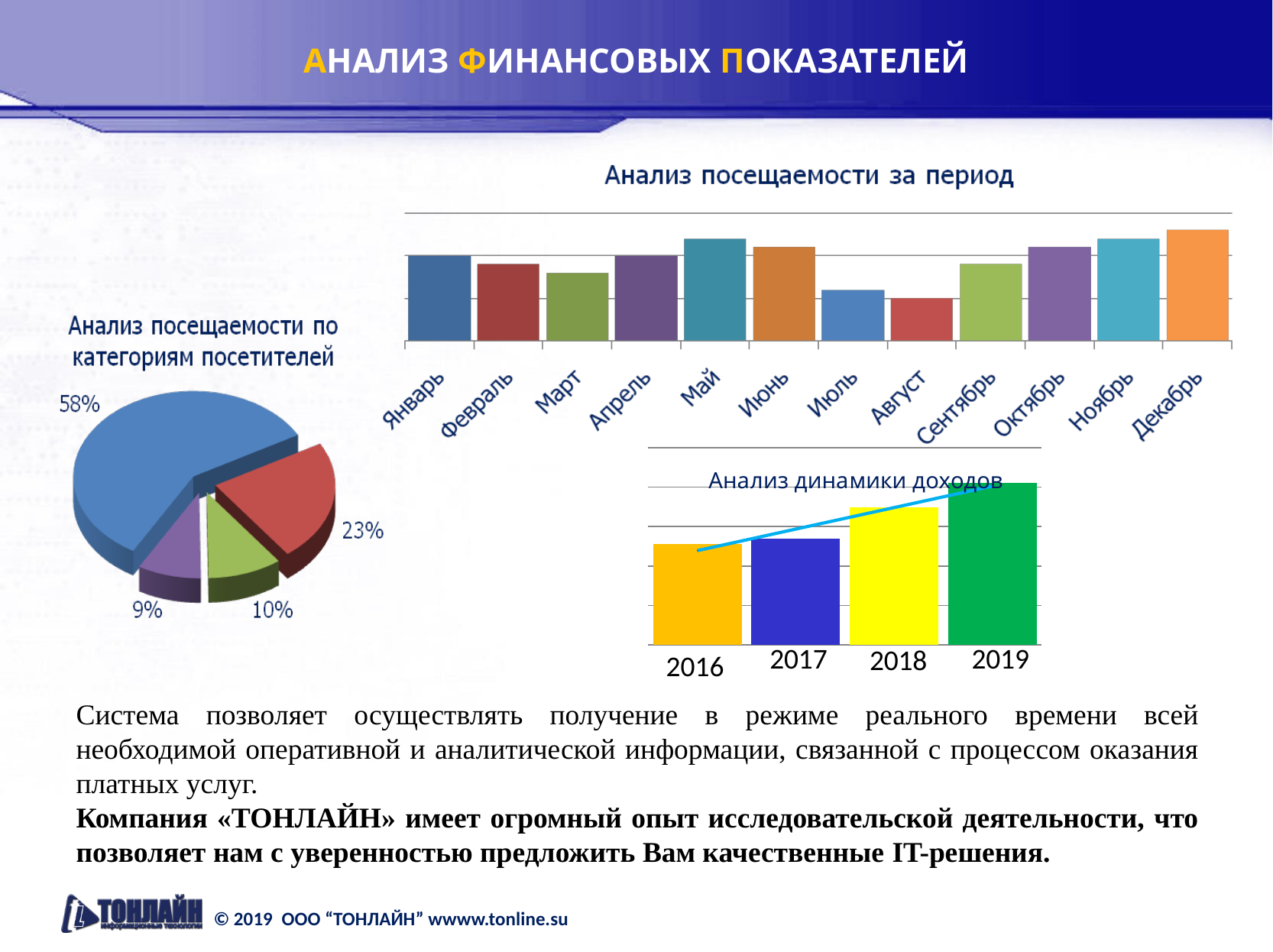
In the chart 'Анализ динамики доходов', do the values rise or fall from 2016 to 2019? Rise In the chart 'Анализ посещаемости за период', which month has the highest bar? Декабрь In the chart 'Анализ динамики доходов', which year has the lowest bar? 2016 What kind of chart is 'Анализ динамики доходов'? Bar chart How many slices does the pie chart 'Анализ посещаемости по категориям посетителей' have? 4 How many months are shown in the chart 'Анализ посещаемости за период'? 12 In the chart 'Анализ посещаемости за период', which month has the lowest bar? Август In the pie chart 'Анализ посещаемости по категориям посетителей', what is the share of the largest slice? 58% In the pie chart 'Анализ посещаемости по категориям посетителей', what is the difference in percentage points between the largest slice and the red slice? 35 In the pie chart 'Анализ посещаемости по категориям посетителей', what is the share of the smallest slice? 9% What kind of chart is 'Анализ посещаемости по категориям посетителей'? Pie chart In the chart 'Анализ посещаемости за период', which is larger, the value for Май or the value for Июль? Май